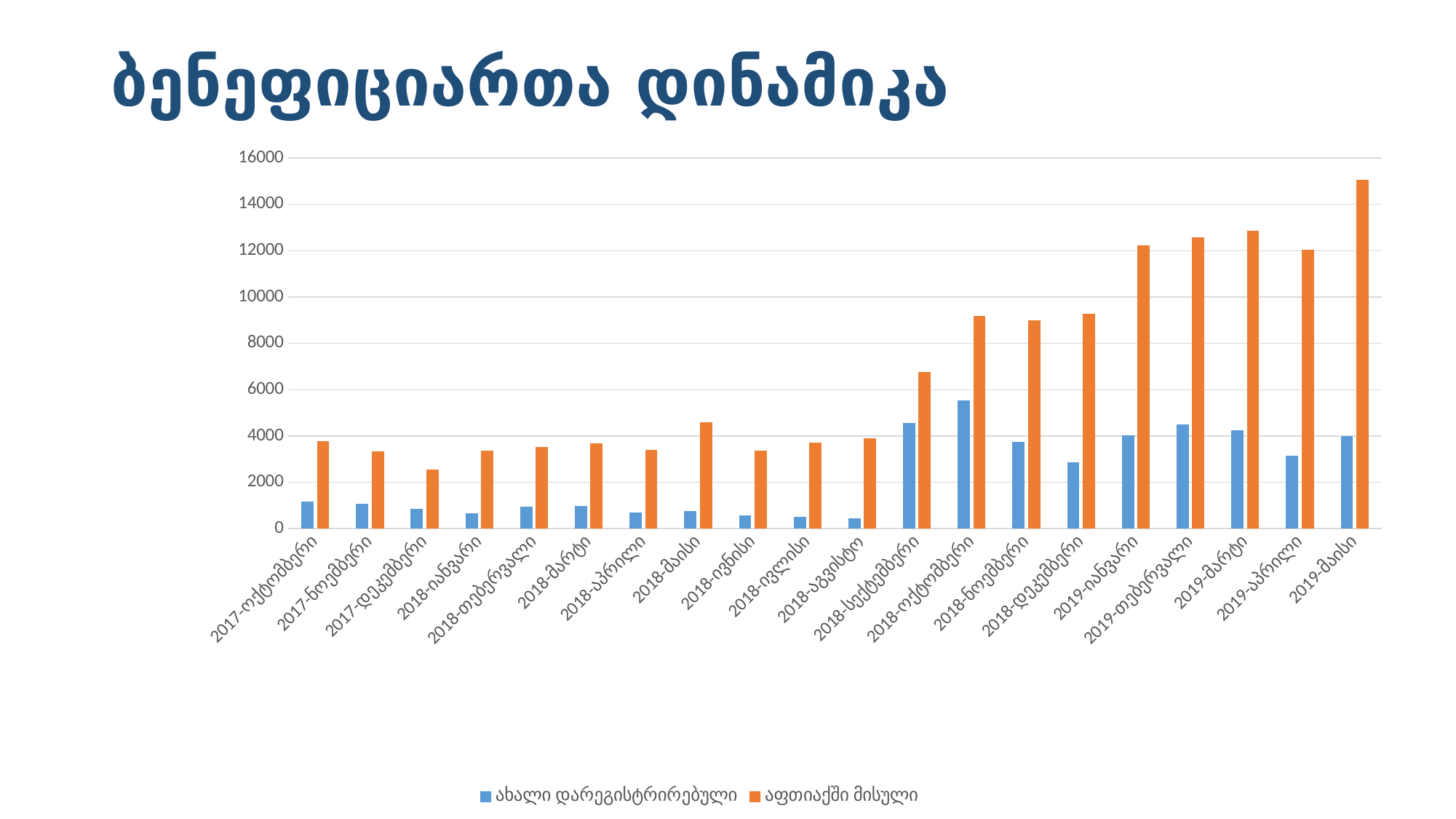
What is the title of the chart on the slide? ბენეფიციართა დინამიკა Which month has the lowest value for აფთიაქში მისული? 2017-დეკემბერი What kind of chart is shown on the slide? bar chart Which month has the highest value for აფთიაქში მისული? 2019-მაისი Which is larger for აფთიაქში მისული: 2019-მარტი or 2019-აპრილი? 2019-მარტი How many series does the legend list? 2 Is the value for ახალი დარეგისტრირებული in 2018-ოქტომბერი greater or less than 4000? greater How many categories (months) are shown on the x axis? 20 Which month has the highest value for ახალი დარეგისტრირებული? 2018-ოქტომბერი Do the values for აფთიაქში მისული generally rise or fall from 2017-ოქტომბერი to 2019-მაისი? rise Is the value for აფთიაქში მისული in 2017-დეკემბერი greater or less than 4000? less Is the value for აფთიაქში მისული in 2019-მაისი greater or less than 14000? greater